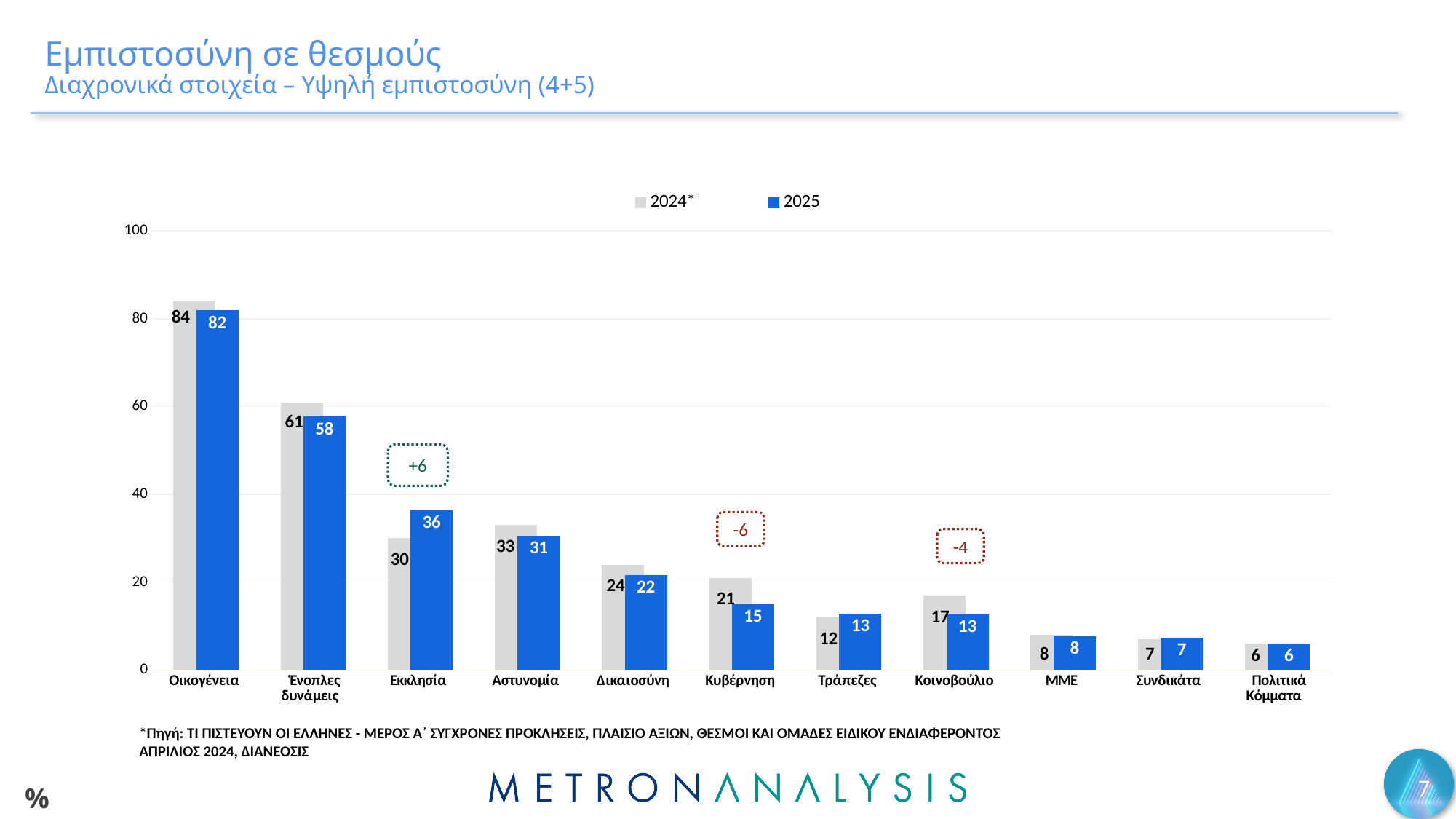
Which is larger for Εκκλησία, the 2024 value or the 2025 value? 2025 Which category has the lowest 2024 value? Πολιτικά Κόμματα What is the 2024 value for Εκκλησία? 30 Which category has the highest 2025 value? Οικογένεια What is the 2025 value for Οικογένεια? 82 How many series does the legend list? 2 How many categories are shown on the x axis? 11 Is the 2025 value for Αστυνομία greater or less than 40? less What is the difference between the 2024 and 2025 values for Ένοπλες δυνάμεις? 3 What is the 2025 value for Κυβέρνηση? 15 What kind of chart is shown on the slide? bar chart Which colour represents the 2025 series? blue